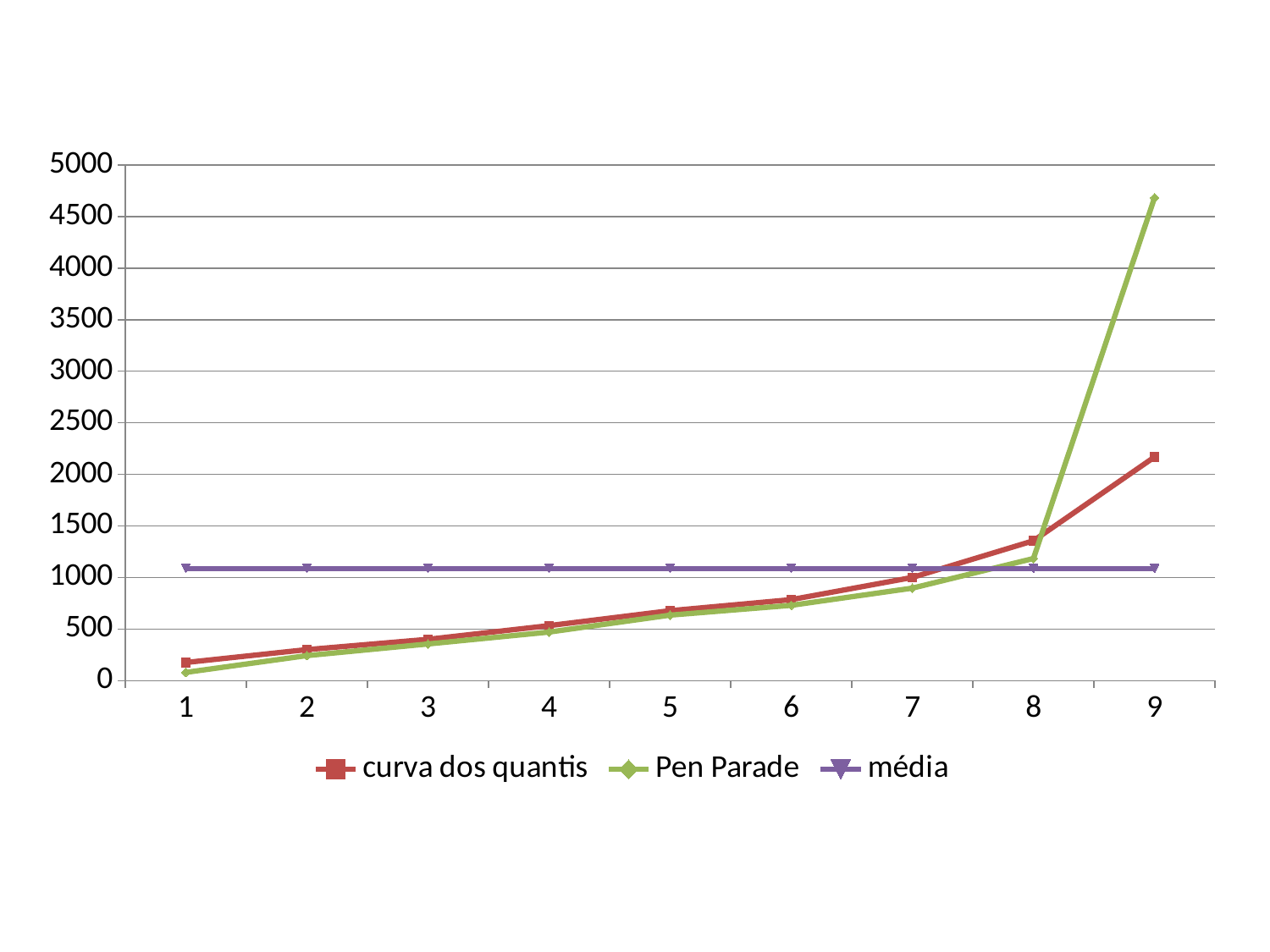
At x = 9, which series is higher: Pen Parade or curva dos quantis? Pen Parade Is the value of curva dos quantis at x = 9 greater or less than 2000? greater Is the value of Pen Parade at x = 9 greater or less than 4500? greater At which x value does Pen Parade reach its highest point? 9 How many points are plotted along the x axis for each series? 9 Is the value of the média line greater or less than 1000? greater Do the values of curva dos quantis rise or fall from x = 1 to x = 9? rise At which x value is curva dos quantis lowest? 1 What kind of chart is shown on the slide? line chart What colour is the média line? purple How many series does the legend list? 3